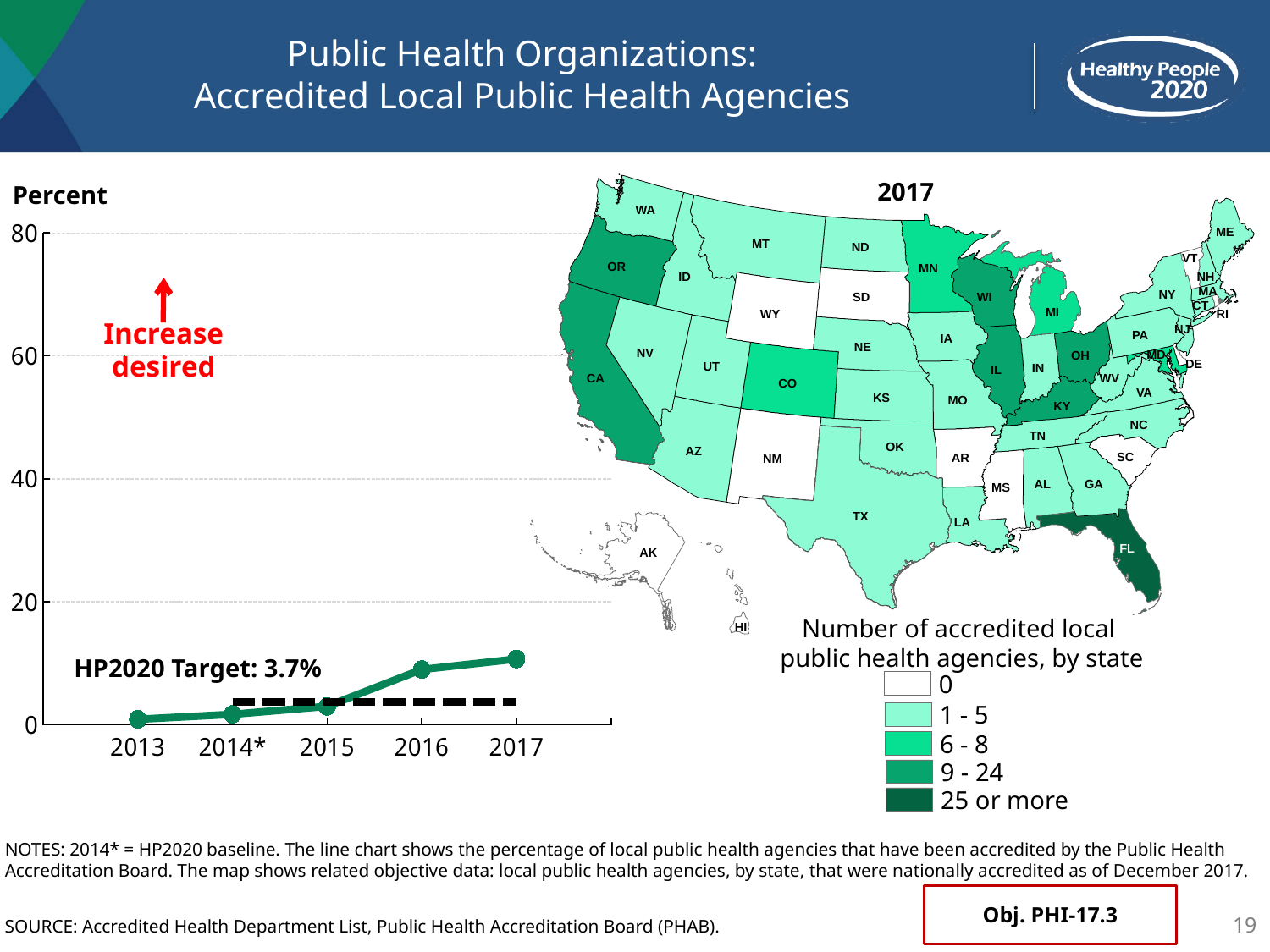
In the line chart on the left, is the value for 2017 greater or less than 20? less In the line chart on the left, what is the HP2020 Target value shown? 3.7% In the line chart on the left, which year has the lowest value? 2013 In the line chart on the left, is the value for 2016 greater or less than 20? less In the line chart on the left, which year has the larger value, 2015 or 2016? 2016 In the line chart on the left, do the values rise or fall from 2013 to 2017? rise In the map on the right, which legend category does FL fall into? 25 or more In the line chart on the left, which year has the highest value? 2017 In the line chart on the left, how many years are plotted along the x axis? 5 What kind of chart is the chart on the left of the slide? line chart In the line chart on the left, what is the label on the y axis? Percent In the map on the right, how many categories does the legend list for the number of accredited local public health agencies? 5